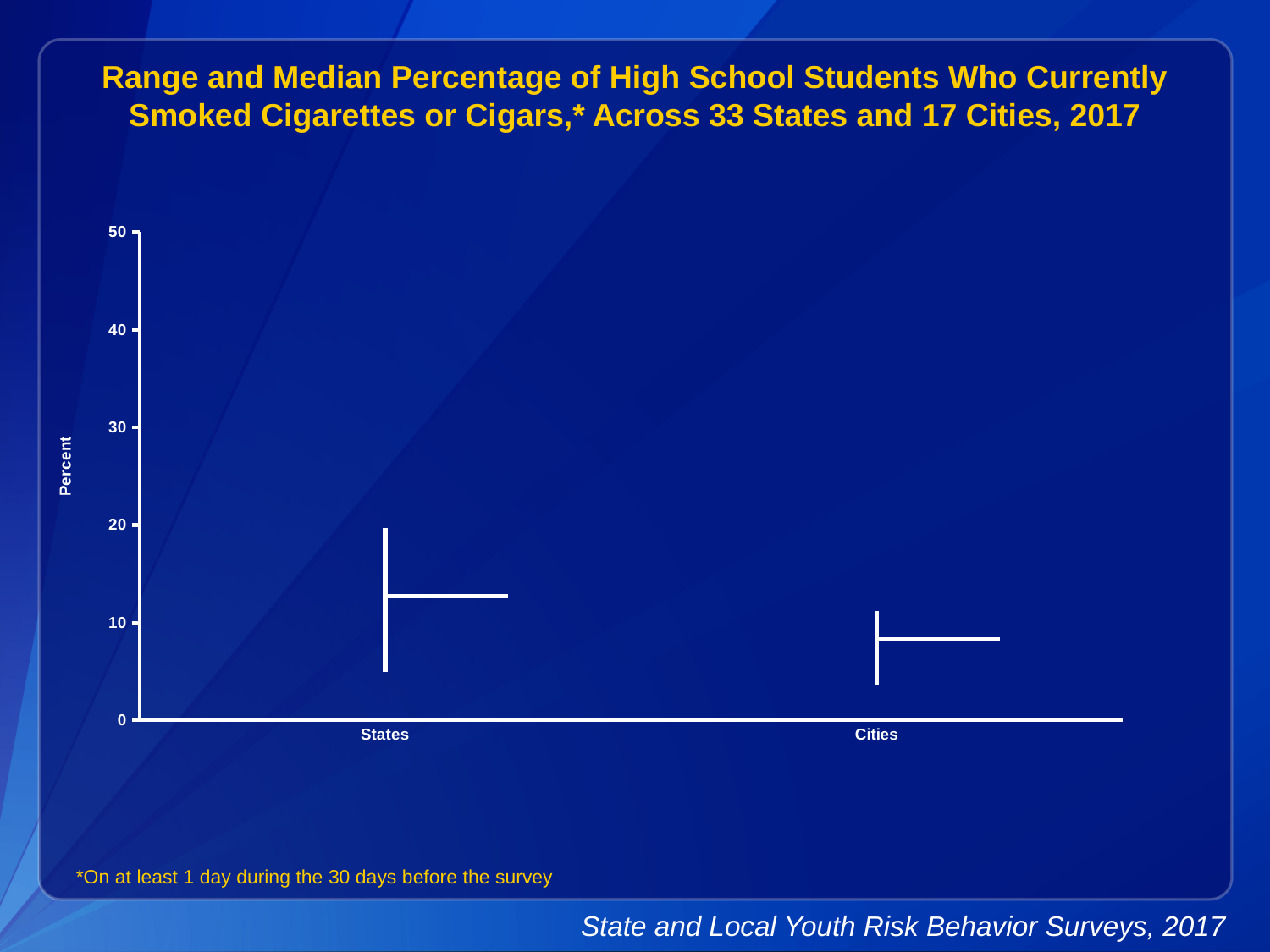
Is the top of the range for States greater or less than 30? less Is the median value for Cities greater or less than 10? less How many categories are shown on the x axis of the chart? 2 Is the bottom of the range for States greater or less than 10? less Does the median value rise or fall from States to Cities? fall Which category has the higher median value, States or Cities? States What is the label of the y axis? Percent Which category has the lower median value? Cities What are the two categories shown on the x axis? States and Cities Which category has the higher top of its range, States or Cities? States